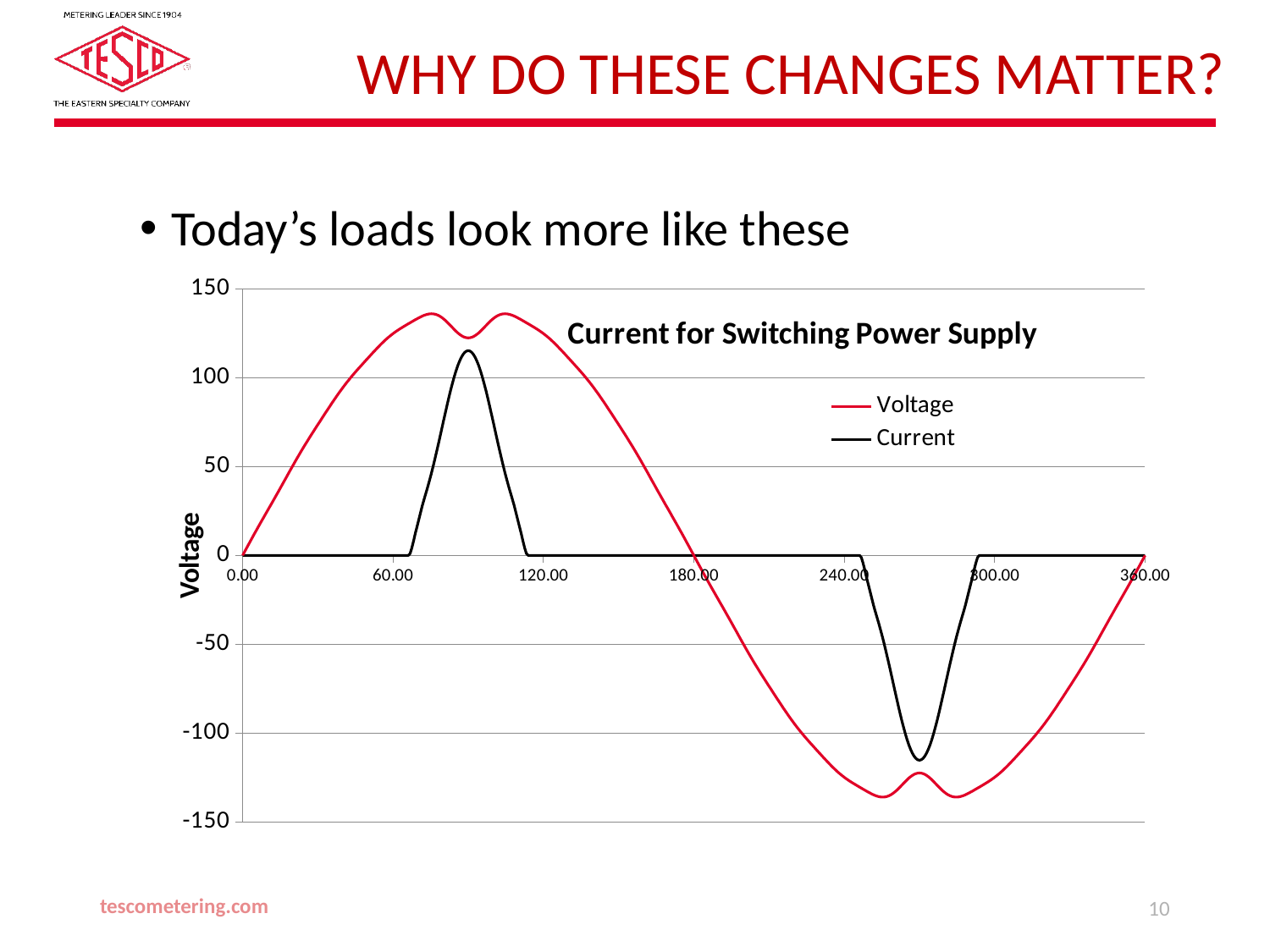
Which series reaches a higher peak value, Voltage or Current? Voltage Is the lowest value of the Voltage series greater or less than -100? less Does the Voltage series rise or fall between 120.00 and 180.00 on the x axis? fall Is the Voltage value at 60.00 greater or less than 100? greater What colour is the Current line in the chart? black Is the peak value of the Current series greater or less than 100? greater What is the title of the chart? Current for Switching Power Supply Does the Voltage series rise or fall between 0.00 and 60.00 on the x axis? rise How many series does the chart legend list? 2 What kind of chart is shown on the slide? line chart